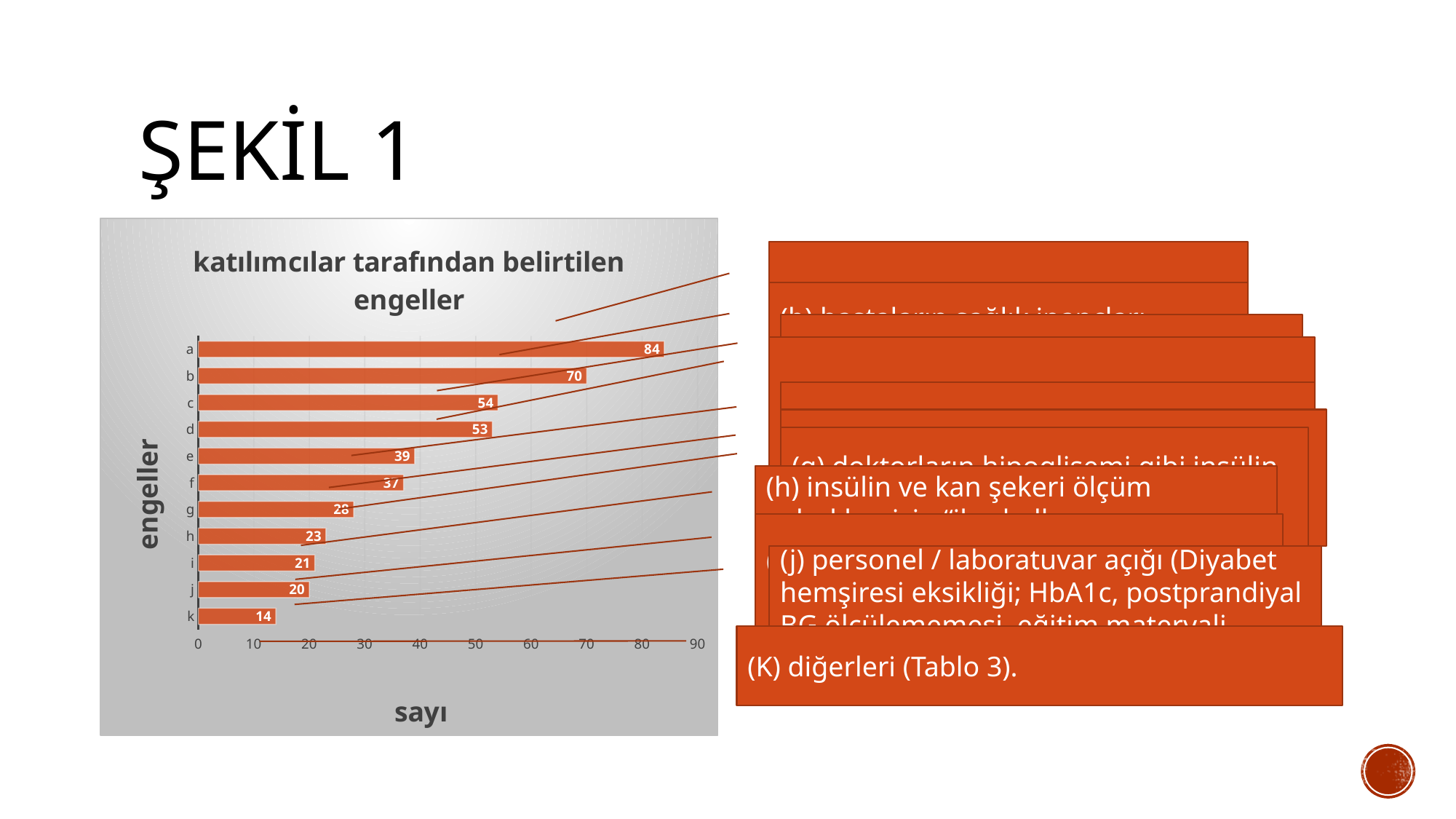
Which category has the highest value? a What is the title of the chart? katılımcılar tarafından belirtilen engeller How many categories are shown in the chart? 11 Which is larger, the value for c or the value for g? c What is the label of the horizontal axis? sayı What is the value for category k? 14 What type of chart is shown on the slide? bar chart What is the value for category e? 39 What is the value for category a? 84 Is the value for category d greater or less than 50? greater Which category has the lowest value? k What is the difference between the values for a and b? 14